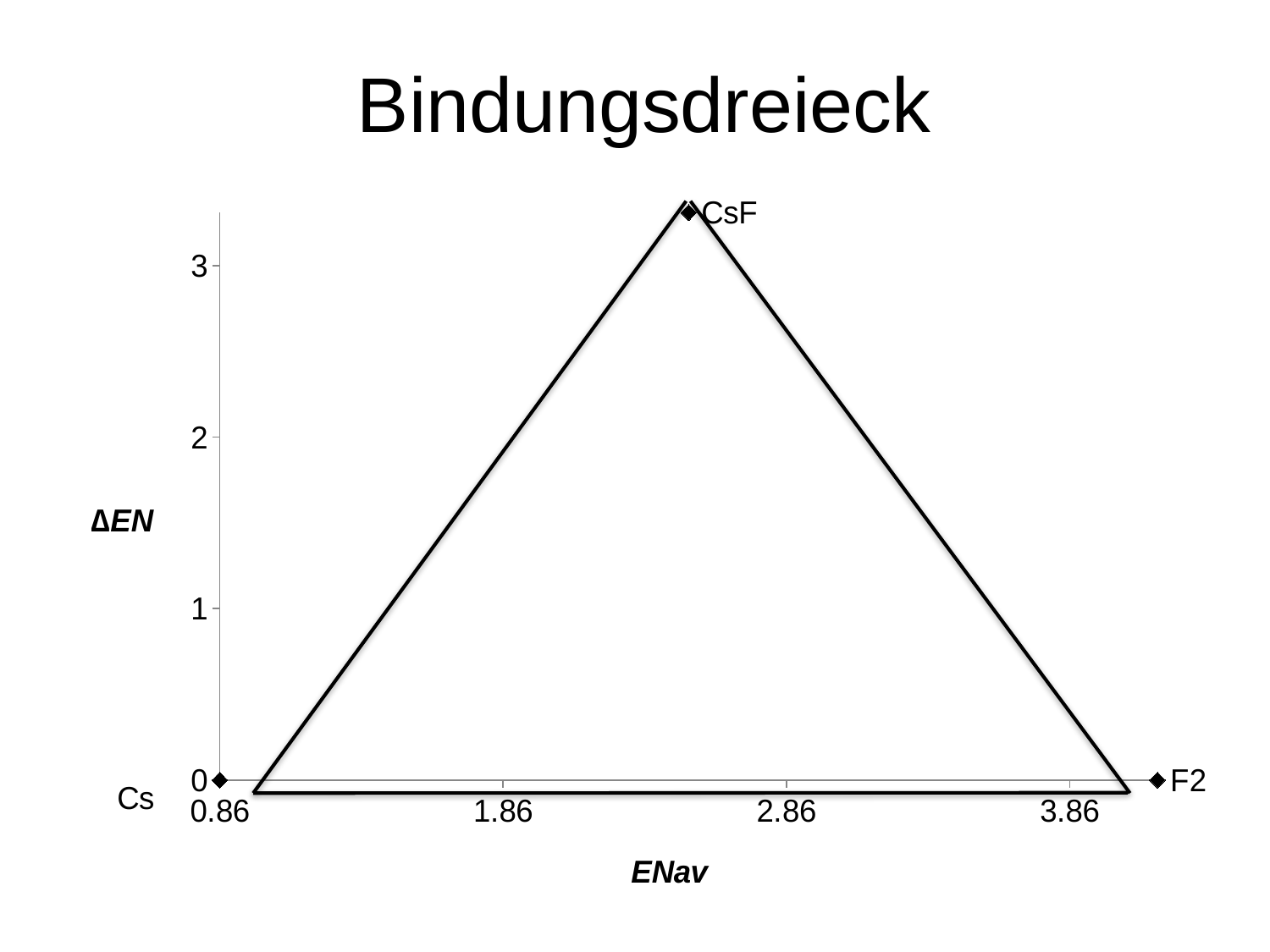
Is the ENav value for F2 greater or less than 3.86? greater What kind of chart is shown on the slide? scatter chart Which has the larger ΔEN value, CsF or Cs? CsF What is the ΔEN value for Cs? 0 What is the label of the x axis? ENav What is the title of the chart? Bindungsdreieck How many labelled data points are plotted on the chart? 3 Is the ΔEN value for CsF greater or less than 3? greater Which point has the highest ΔEN value? CsF What is the ENav value for Cs? 0.86 What is the ΔEN value for F2? 0 Which point has the lowest ENav value? Cs